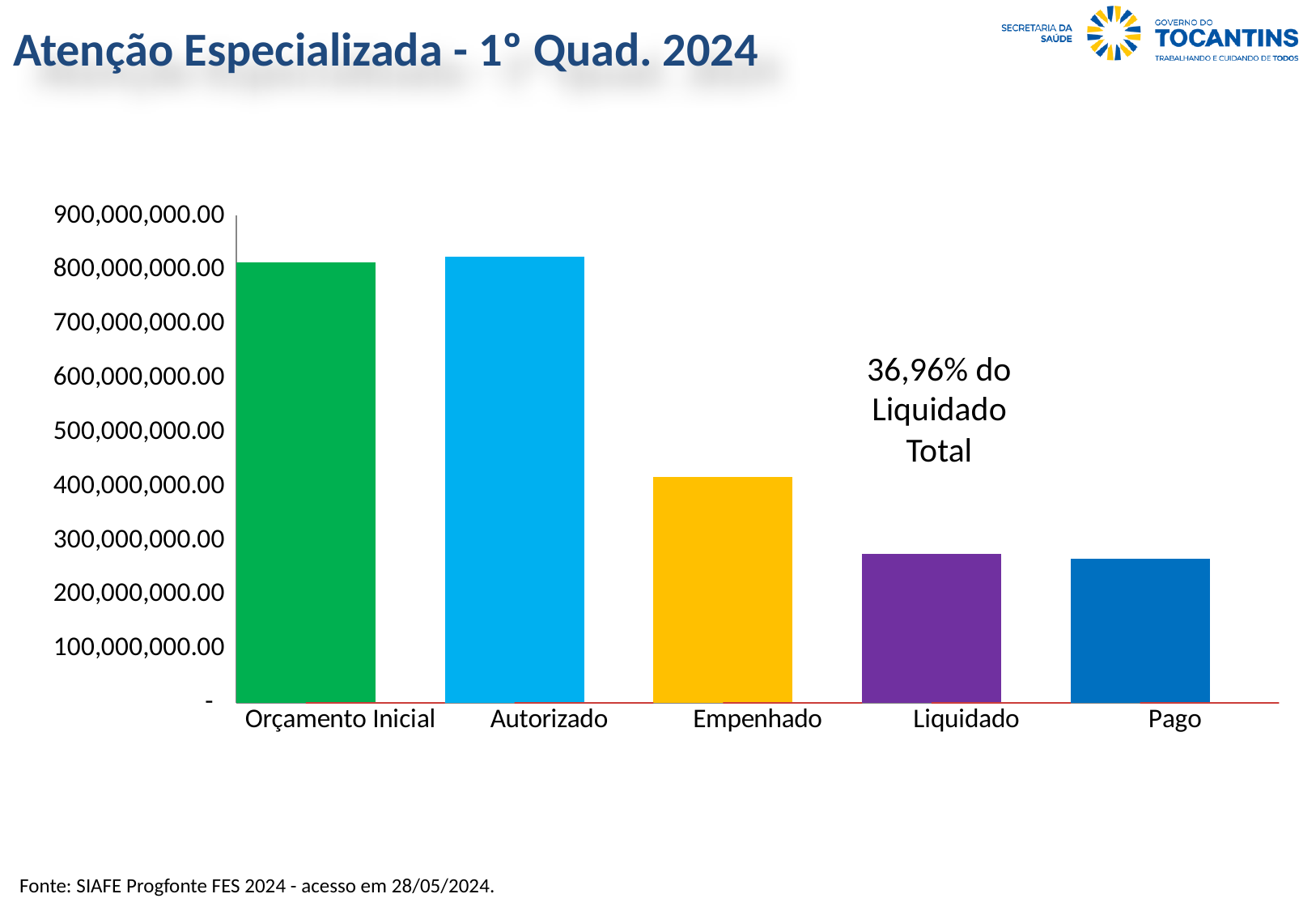
Is the value for Empenhado greater or less than 400,000,000.00? greater Which is larger, the value for Empenhado or the value for Liquidado? Empenhado Is the value for Orçamento Inicial greater or less than 900,000,000.00? less Moving from Autorizado to Pago along the x axis, do the values rise or fall? fall What is the title of the slide containing the chart? Atenção Especializada - 1° Quad. 2024 How many categories are plotted on the x axis? 5 Is the value for Liquidado greater or less than 300,000,000.00? less What percentage is stated in the annotation next to the Liquidado bar? 36,96% do Liquidado Total What kind of chart is shown on the slide? bar chart Which is larger, the value for Autorizado or the value for Pago? Autorizado